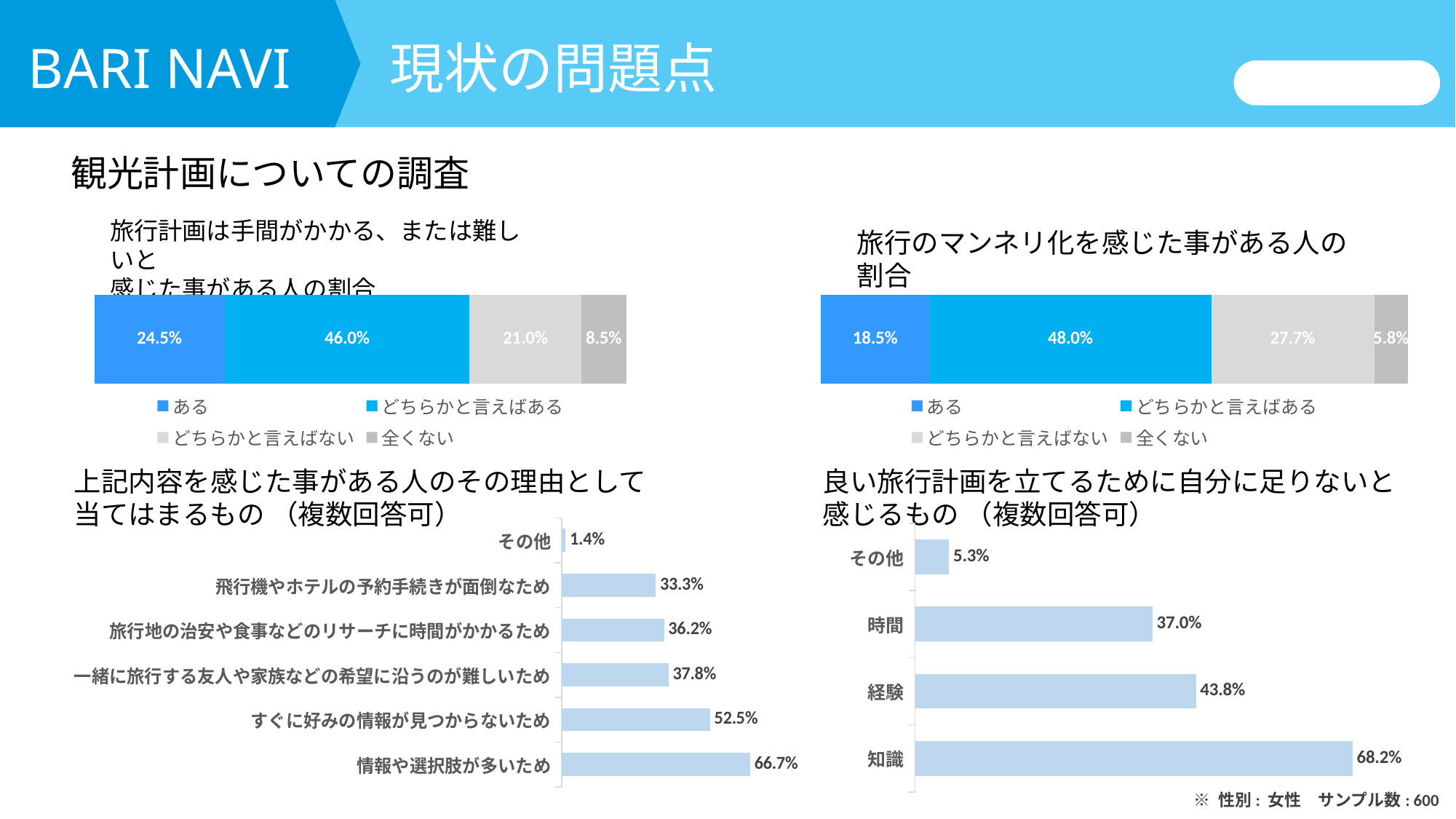
In the top-right stacked bar chart (旅行のマンネリ化を感じた事がある人の割合), what is the value for 全くない? 5.8% In the bottom-right bar chart, which is larger, 経験 or 時間? 経験 In the bottom-left bar chart, what is the difference between 情報や選択肢が多いため and 飛行機やホテルの予約手続きが面倒なため? 33.4% In the top-right stacked bar chart, what is the combined share of ある and どちらかと言えばある? 66.5% In the top-left stacked bar chart, what is the value for どちらかと言えばある? 46.0% How many categories are shown in the bottom-left bar chart? 6 How many legend entries does the top-left stacked bar chart list? 4 In the bottom-left bar chart (上記内容を感じた事がある人のその理由として当てはまるもの), which category has the highest value? 情報や選択肢が多いため In the bottom-left bar chart, what is the value for すぐに好みの情報が見つからないため? 52.5% In the top-left stacked bar chart (旅行計画は手間がかかる、または難しいと感じた事がある人の割合), what is the value for ある? 24.5% In the bottom-right bar chart (良い旅行計画を立てるために自分に足りないと感じるもの), which category has the lowest value? その他 In the top-right stacked bar chart, what is the value for どちらかと言えばない? 27.7%